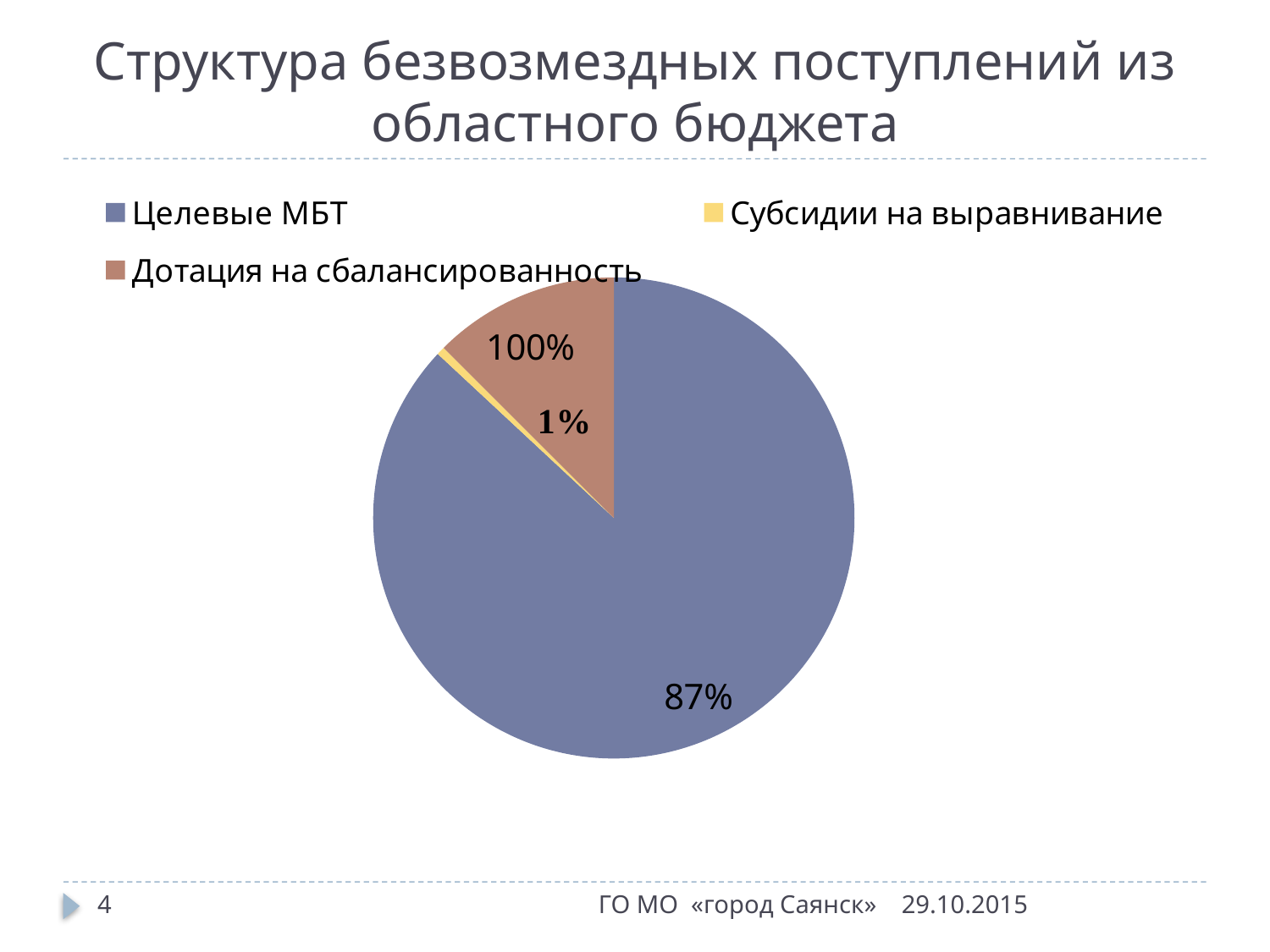
Which slice is larger: Целевые МБТ or Дотация на сбалансированность? Целевые МБТ How many entries does the legend of the pie chart list? 3 What share of the pie is labelled for Субсидии на выравнивание? 1% What colour is the slice for Целевые МБТ in the pie chart? blue What share of the pie is labelled for Целевые МБТ? 87% How many slices does the pie chart have? 3 What is the difference between the labelled shares of Целевые МБТ and Субсидии на выравнивание? 86% Which slice is larger: Дотация на сбалансированность or Субсидии на выравнивание? Дотация на сбалансированность What kind of chart is shown on the slide? pie chart Which category has the largest slice of the pie? Целевые МБТ Which category has the smallest slice of the pie? Субсидии на выравнивание What is the title of the slide containing the pie chart? Структура безвозмездных поступлений из областного бюджета